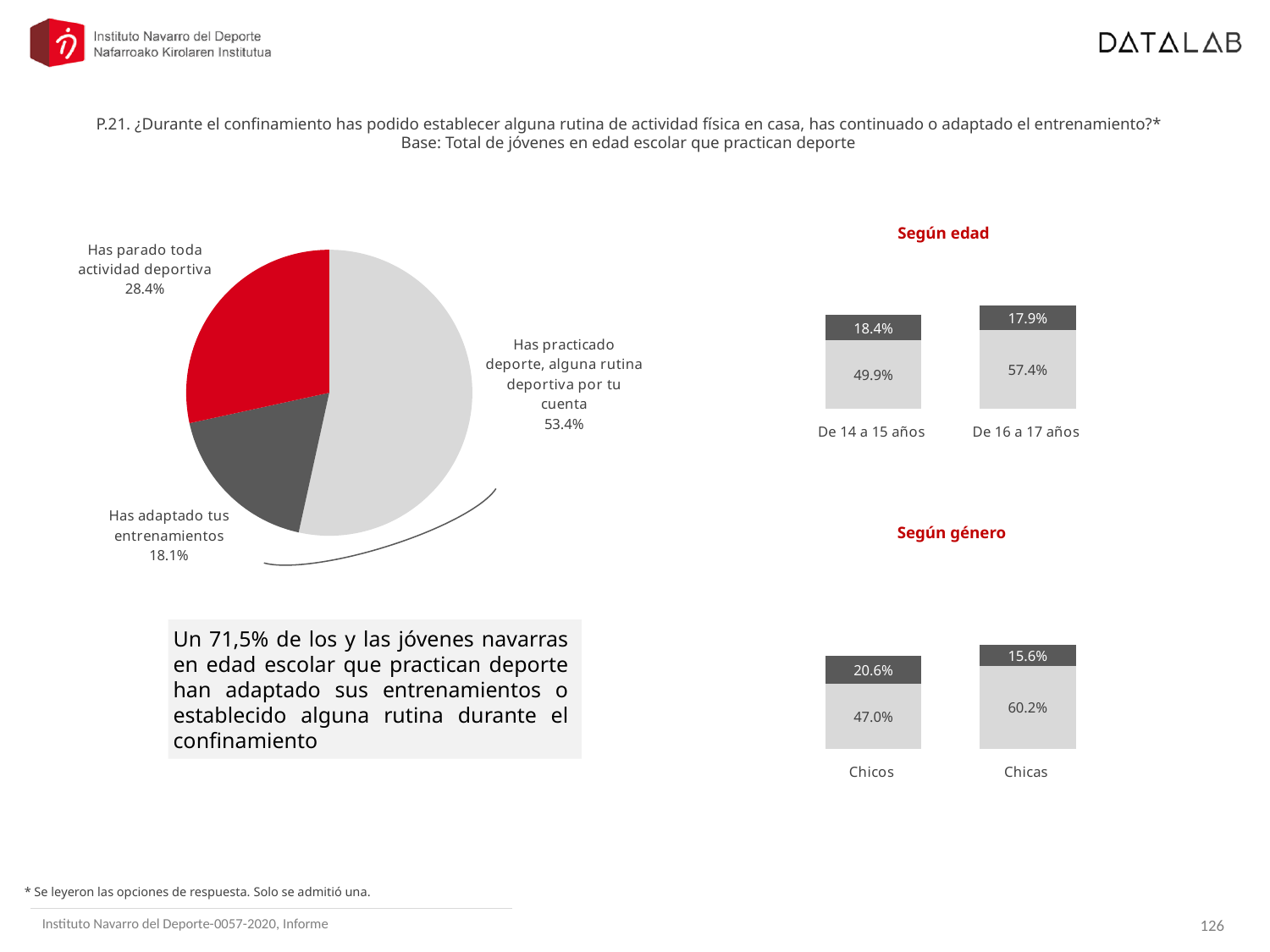
In the pie chart on the left, which category has the smallest slice? Has adaptado tus entrenamientos In the pie chart on the left, what percentage corresponds to 'Has parado toda actividad deportiva'? 28.4% In the 'Según género' chart, what is the value of the lower (light grey) segment for 'Chicas'? 60.2% In the 'Según edad' chart, what is the value of the lower (light grey) segment for 'De 16 a 17 años'? 57.4% In the 'Según género' chart, what is the difference between the lower (light grey) segment values for 'Chicas' and 'Chicos'? 13.2% What type of chart is shown on the left of the slide? Pie chart In the 'Según género' chart, which group has the larger upper (dark grey) segment, 'Chicos' or 'Chicas'? Chicos In the pie chart on the left, which category has the largest slice? Has practicado deporte, alguna rutina deportiva por tu cuenta How many slices does the pie chart on the left have? 3 In the 'Según edad' chart, what is the value of the upper (dark grey) segment for 'De 14 a 15 años'? 18.4% In the pie chart on the left, what percentage corresponds to 'Has adaptado tus entrenamientos'? 18.1% In the pie chart on the left, what share of respondents answered 'Has practicado deporte, alguna rutina deportiva por tu cuenta'? 53.4%